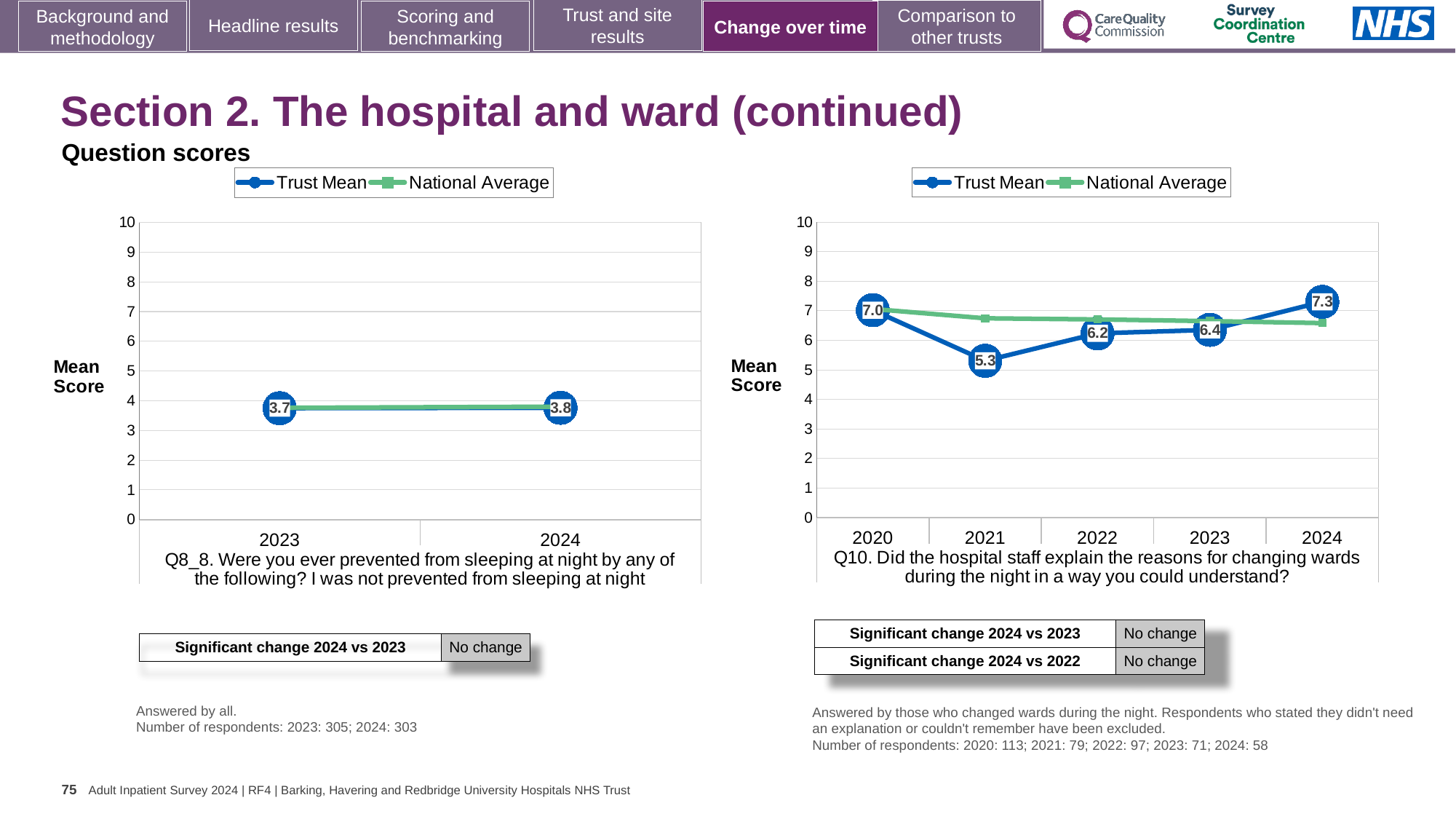
On the right chart (Q10), which year has the highest Trust Mean score? 2024 On the right chart (Q10), which year has the lowest Trust Mean score? 2021 On the right chart (Q10), how many series does the legend list? 2 On the left chart (Q8_8), what is the Trust Mean score for 2023? 3.7 On the right chart (Q10), what is the Trust Mean score for 2021? 5.3 On the right chart (Q10), is the National Average value for 2024 greater or less than 5? greater What type of chart is the right chart (Q10)? Line chart On the right chart (Q10), what is the difference between the Trust Mean scores for 2024 and 2021? 2.0 On the right chart (Q10), is the Trust Mean score for 2020 or 2022 larger? 2020 On the left chart (Q8_8), how many years are plotted on the x axis? 2 On the left chart (Q8_8), what is the Trust Mean score for 2024? 3.8 On the right chart (Q10), what is the Trust Mean score for 2024? 7.3